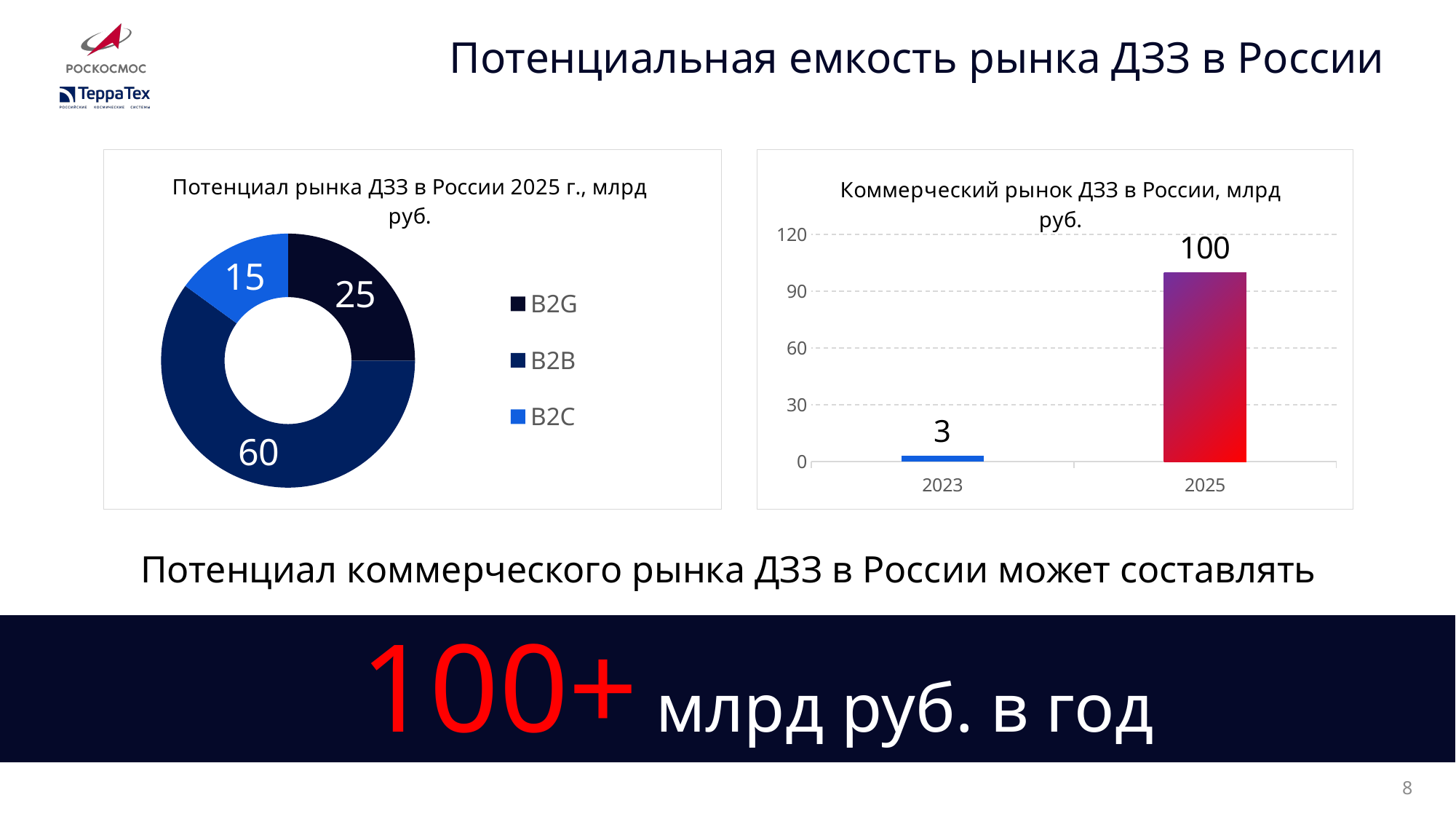
In the left chart (Потенциал рынка ДЗЗ в России 2025 г.), how many segments does the legend list? 3 In the left chart (Потенциал рынка ДЗЗ в России 2025 г.), which segment is the smallest? B2C In the left chart (Потенциал рынка ДЗЗ в России 2025 г.), what is the value for B2B? 60 In the right chart (Коммерческий рынок ДЗЗ в России), what is the difference between the 2025 and 2023 values? 97 What kind of chart is the left chart (Потенциал рынка ДЗЗ в России 2025 г.)? Donut (pie) chart In the left chart (Потенциал рынка ДЗЗ в России 2025 г.), which segment is the largest? B2B In the right chart (Коммерческий рынок ДЗЗ в России), what is the value for 2025? 100 What kind of chart is the right chart (Коммерческий рынок ДЗЗ в России)? Bar chart In the left chart (Потенциал рынка ДЗЗ в России 2025 г.), what share of the total does B2B represent? 60% In the left chart (Потенциал рынка ДЗЗ в России 2025 г.), what is the value for B2G? 25 In the right chart (Коммерческий рынок ДЗЗ в России), what is the value for 2023? 3 In the left chart (Потенциал рынка ДЗЗ в России 2025 г.), what is the difference between the B2B and B2G values? 35